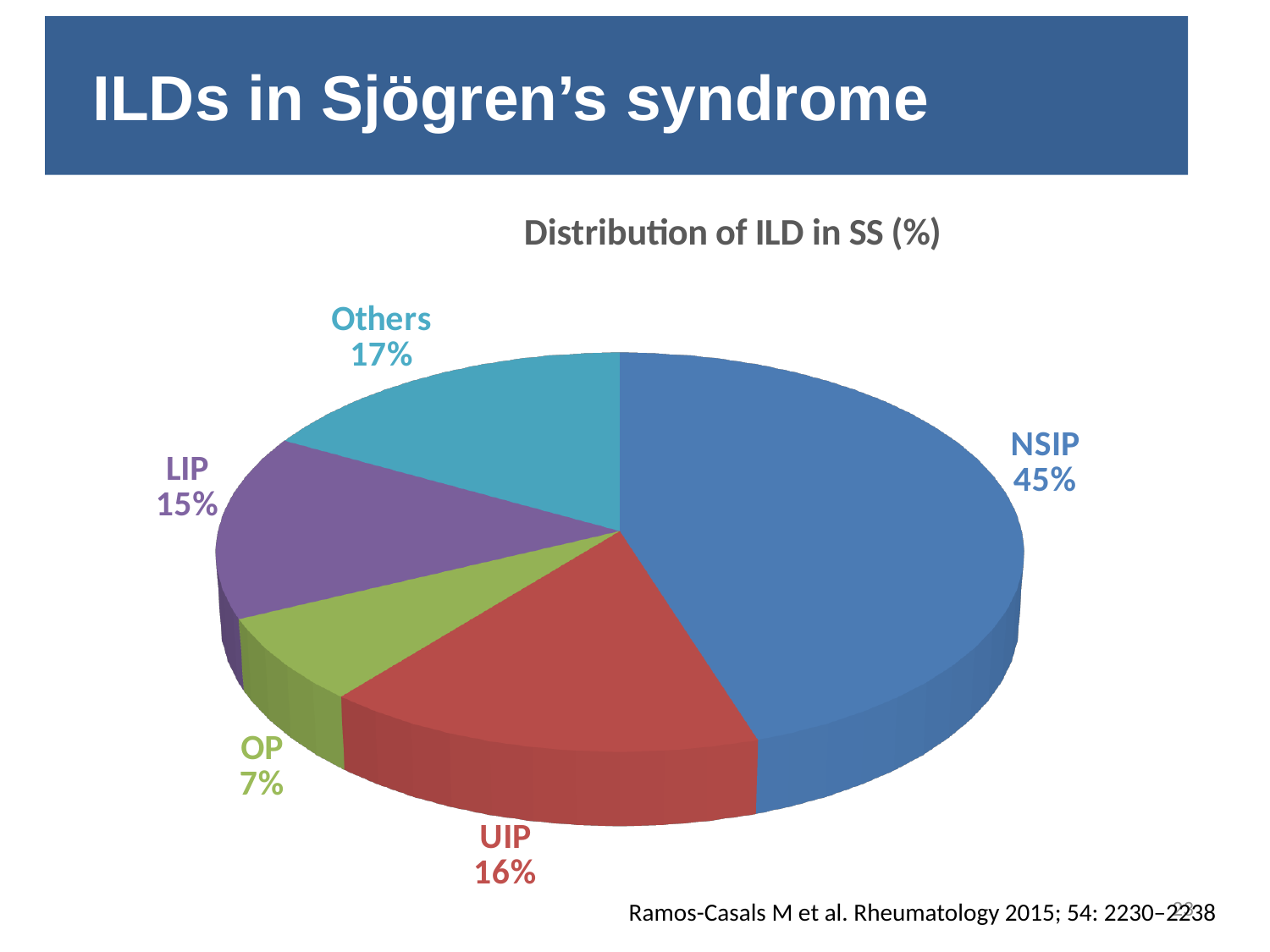
Which category has the smallest slice of the pie? OP What is the difference in percentage points between NSIP and Others? 28 How many categories are shown in the pie chart? 5 What is the value shown for OP? 7% What share of the pie does NSIP account for? 45% What is the chart's title? Distribution of ILD in SS (%) Which is larger, the share for UIP or the share for OP? UIP What is the value shown for LIP? 15% Which category has the largest slice of the pie? NSIP What type of chart is shown on the slide? pie chart What is the value shown for UIP? 16% What colour is the NSIP slice? blue